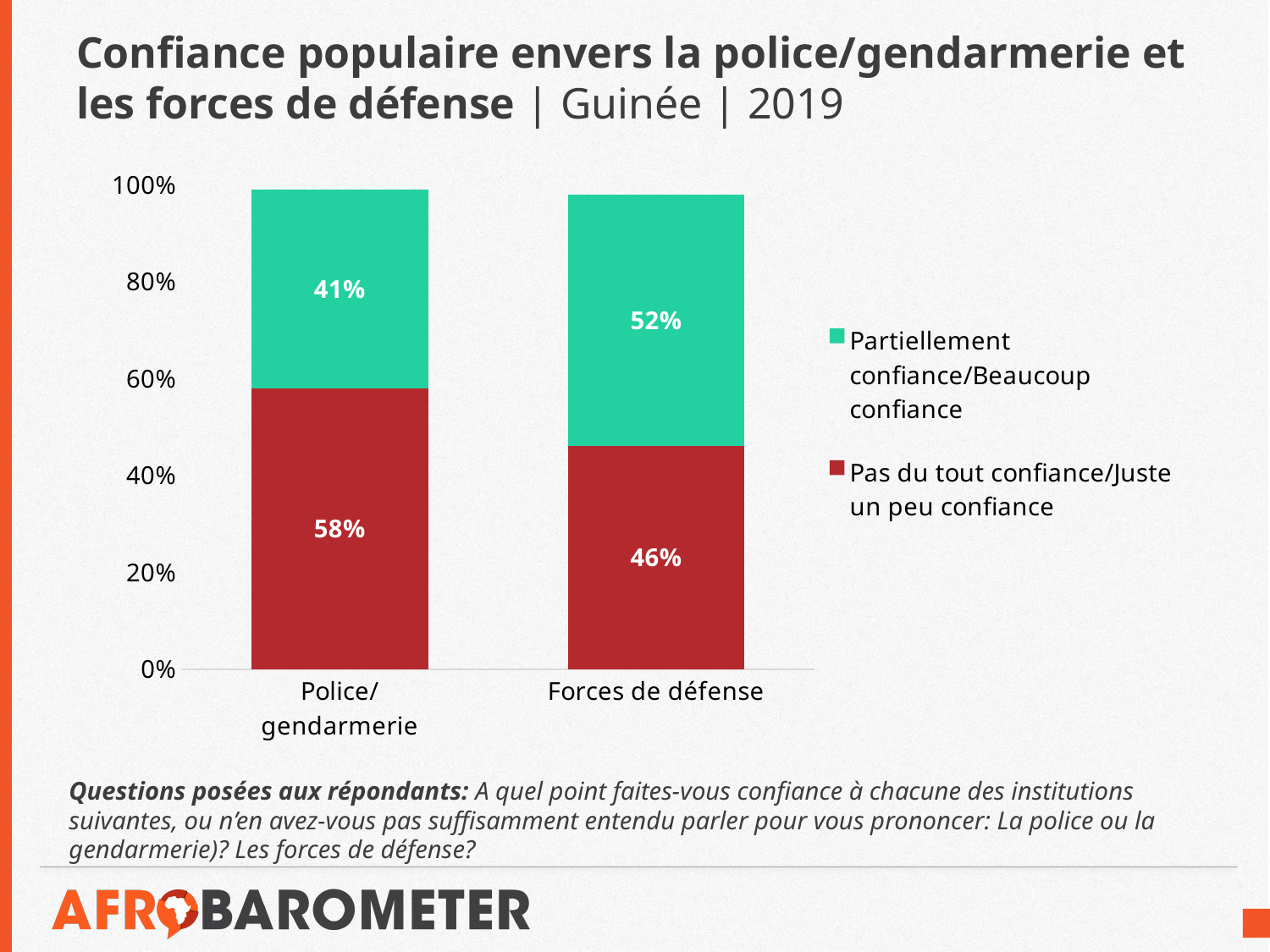
What is the value for 'Partiellement confiance/Beaucoup confiance' for Police/gendarmerie? 41% What percentage of respondents have 'Partiellement confiance/Beaucoup confiance' in the Forces de défense? 52% Is the 'Partiellement confiance/Beaucoup confiance' value larger for Police/gendarmerie or for Forces de défense? Forces de défense Which institution has the lower share of 'Partiellement confiance/Beaucoup confiance'? Police/gendarmerie What is the value for 'Pas du tout confiance/Juste un peu confiance' for Forces de défense? 46% Which institution has the higher share of 'Pas du tout confiance/Juste un peu confiance'? Police/gendarmerie What is the difference between the 'Pas du tout confiance/Juste un peu confiance' values for Police/gendarmerie and Forces de défense? 12 percentage points How many series does the legend list? 2 What is the total of the stacked bar for Police/gendarmerie? 99% What kind of chart is shown on the slide? Stacked bar chart What percentage of respondents have 'Pas du tout confiance/Juste un peu confiance' in the Police/gendarmerie? 58% How many institutions (categories) are shown on the x axis? 2